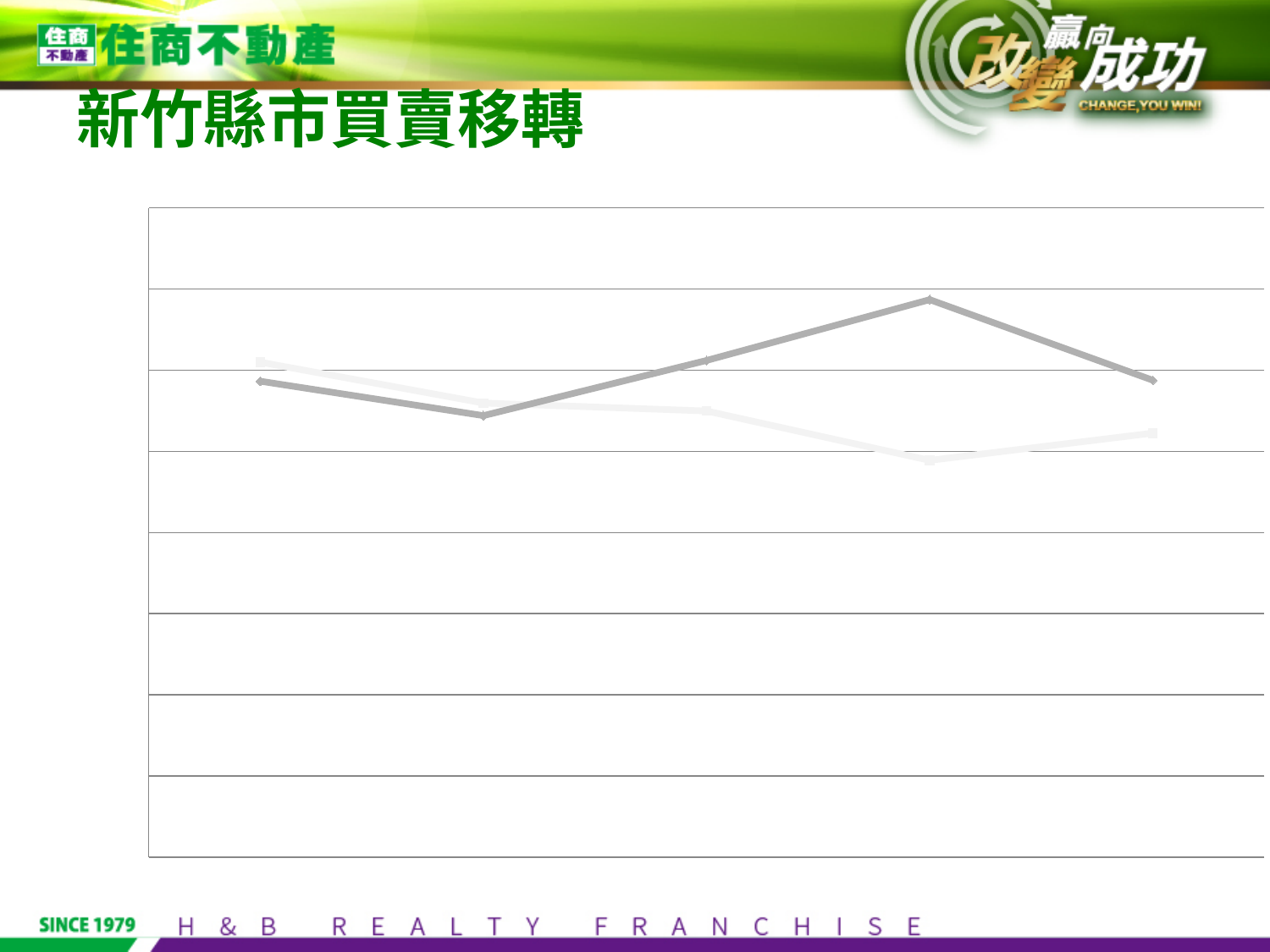
What is the title shown above the chart on the slide? 新竹縣市買賣移轉 At the leftmost point, which line is higher, the darker gray line or the lighter gray line? the lighter gray line Does the chart display a legend? No Does the darker gray line rise or fall between its third and fourth points from the left? rise Which point of the darker gray line is the highest, counting from the left? the fourth point Which point of the lighter gray line is the lowest, counting from the left? the fourth point At the rightmost point, which line is higher, the darker gray line or the lighter gray line? the darker gray line Does the lighter gray line rise or fall between its first and second points from the left? fall Does the darker gray line rise or fall between its fourth and fifth points from the left? fall How many lines are plotted on the chart? 2 How many data points does each line on the chart have? 5 What kind of chart is shown on the slide? line chart